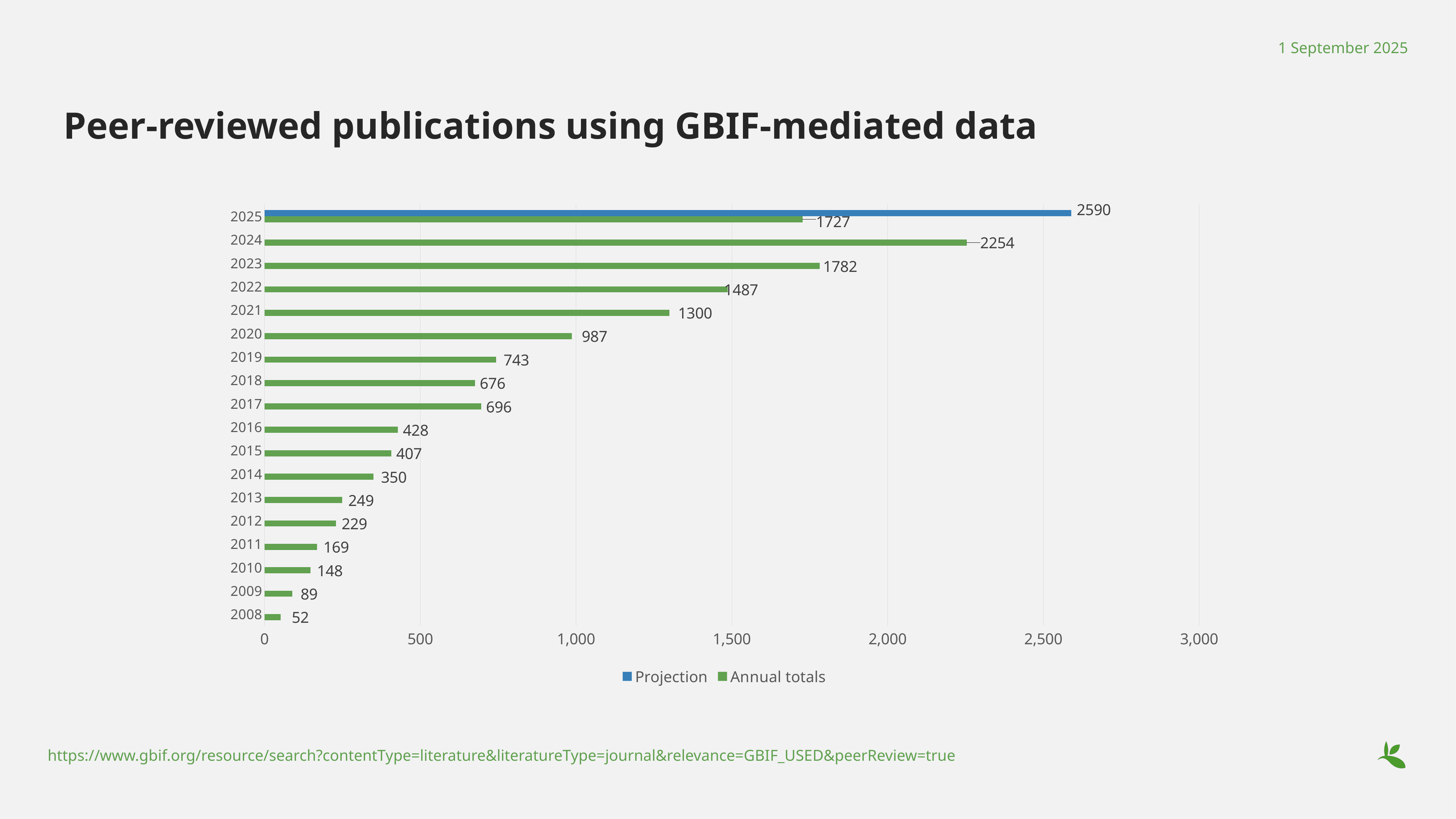
What is the annual total for 2008? 52 What is the difference between the 2025 projection and the 2025 annual total? 863 How many years are shown on the chart? 18 Which year has the lowest annual total? 2008 Which is larger, the annual total for 2017 or for 2018? 2017 What is the difference between the annual totals for 2024 and 2023? 472 What is the projected value for 2025? 2590 What is the annual total of peer-reviewed publications for 2024? 2254 Which year has the highest annual total? 2024 Which series is shown in blue? Projection How many series does the legend list? 2 What kind of chart is shown on the slide? Bar chart